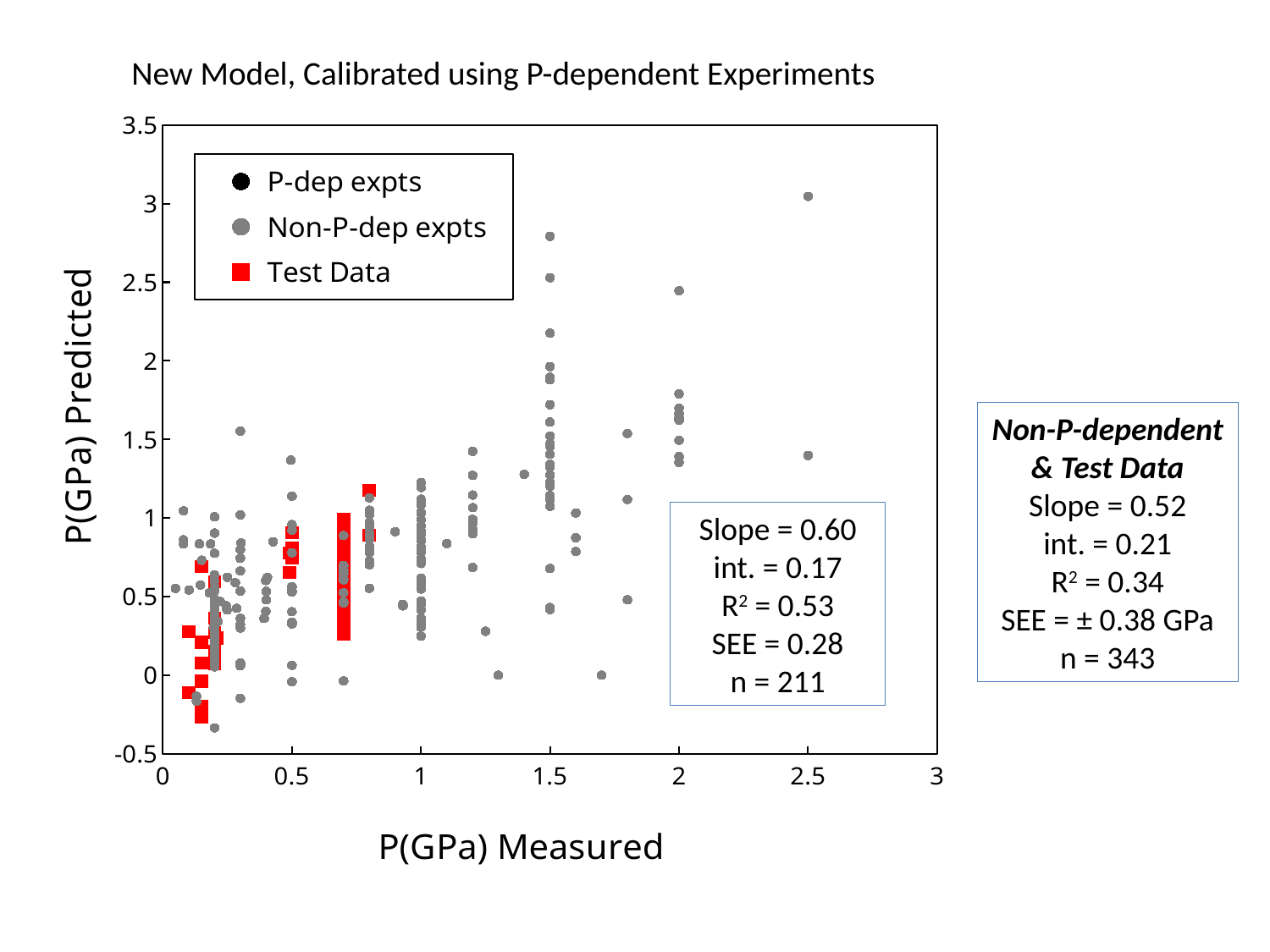
What is the label of the x axis? P(GPa) Measured What are the three entries in the chart legend? P-dep expts, Non-P-dep expts, Test Data Are the Test Data points at a measured pressure of 0.7 GPa greater or less than 1.5 on the predicted axis? less What kind of chart is shown on the slide? Scatter chart What is the difference between the n for Non-P-dependent & Test Data (343) and the n in the plot-area box (211)? 132 How many series does the legend list? 3 Do the predicted pressures generally rise or fall as measured pressure increases along the x axis? Rise What SEE is reported for the Non-P-dependent & Test Data? ± 0.38 GPa What slope is reported in the annotation box for the P-dependent calibration? 0.60 Is the highest Non-P-dep point at a measured pressure of 1.5 GPa greater or less than 2.5 on the predicted axis? greater What is the value of n reported in the annotation box inside the plot area? 211 What R² value is reported for the Non-P-dependent & Test Data? 0.34